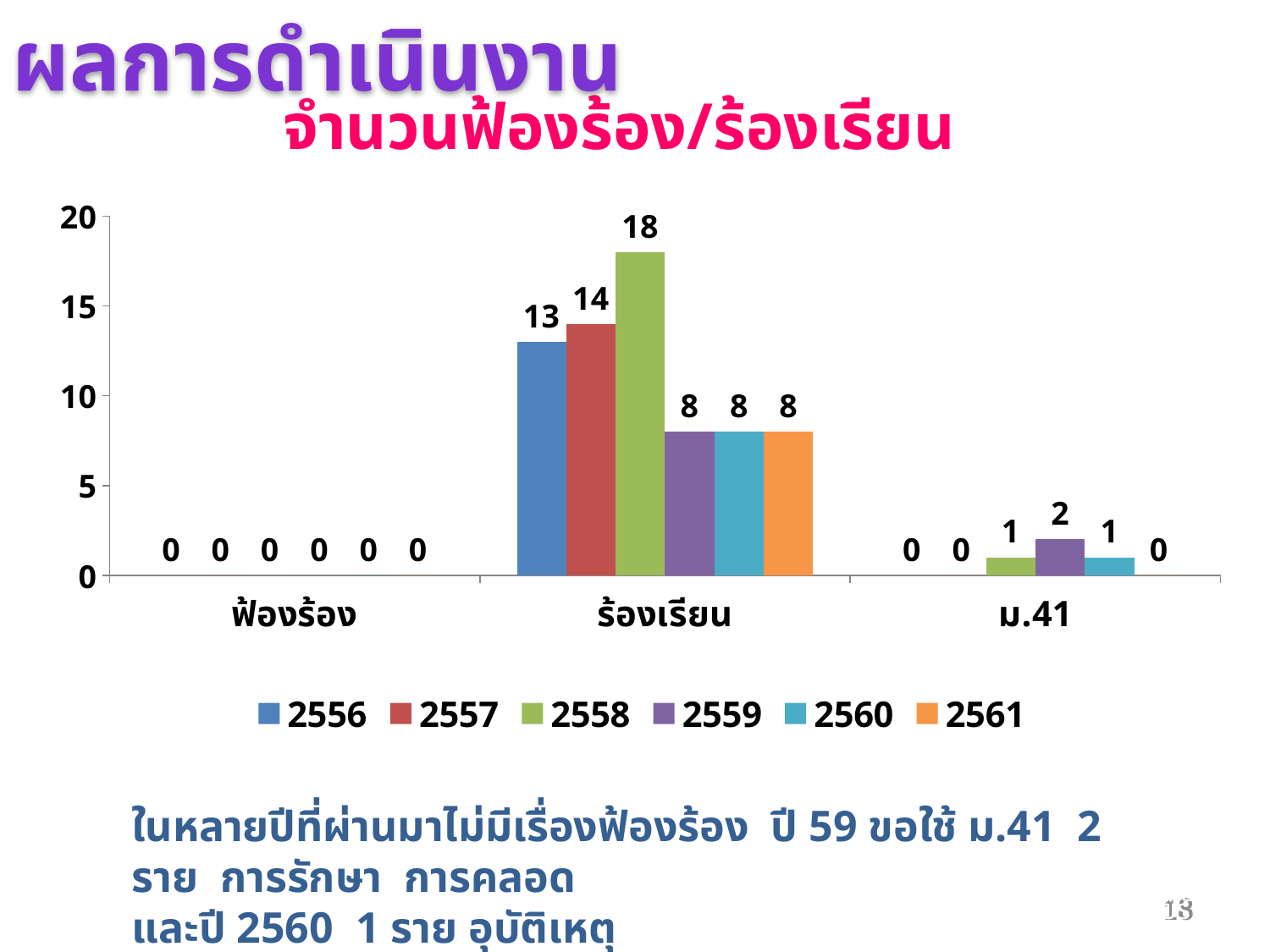
What is the value for 2559 in the ม.41 category? 2 Which year has the highest value in the ม.41 category? 2559 Which year has the highest value in the ร้องเรียน category? 2558 What kind of chart is shown on the slide? Bar chart What is the difference between the 2558 and 2557 values in the ร้องเรียน category? 4 What is the value for 2561 in the ฟ้องร้อง category? 0 What is the title of the chart? จำนวนฟ้องร้อง/ร้องเรียน What is the value for 2556 in the ร้องเรียน category? 13 What is the value for 2558 in the ร้องเรียน category? 18 How many series does the legend list? 6 Which is larger in the ร้องเรียน category, the value for 2557 or the value for 2560? 2557 How many categories are shown on the x axis? 3